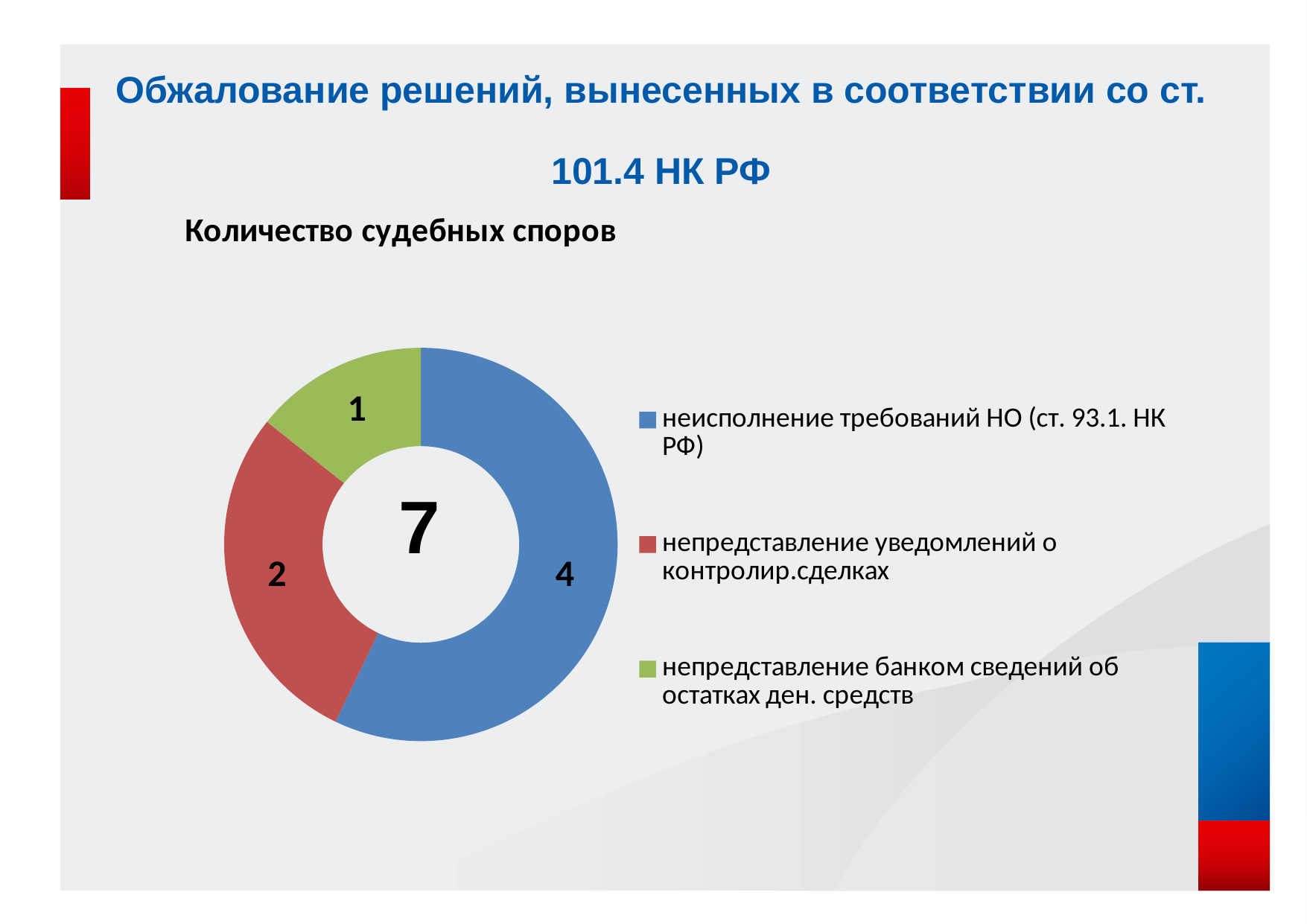
What is the value for "непредставление уведомлений о контролир.сделках"? 2 What is the value for "непредставление банком сведений об остатках ден. средств"? 1 Which category has the highest value? неисполнение требований НО (ст. 93.1. НК РФ) Which category has the lowest value? непредставление банком сведений об остатках ден. средств How many categories does the chart show? 3 What is the difference between the values for "неисполнение требований НО (ст. 93.1. НК РФ)" and "непредставление уведомлений о контролир.сделках"? 2 What number is printed in the centre of the doughnut chart? 7 What is the value for "неисполнение требований НО (ст. 93.1. НК РФ)"? 4 Which is larger: the value for "непредставление уведомлений о контролир.сделках" or for "непредставление банком сведений об остатках ден. средств"? непредставление уведомлений о контролир.сделках What type of chart is shown on the slide? Doughnut (pie) chart What is the total of all values shown in the chart? 7 What is the title of the chart? Количество судебных споров